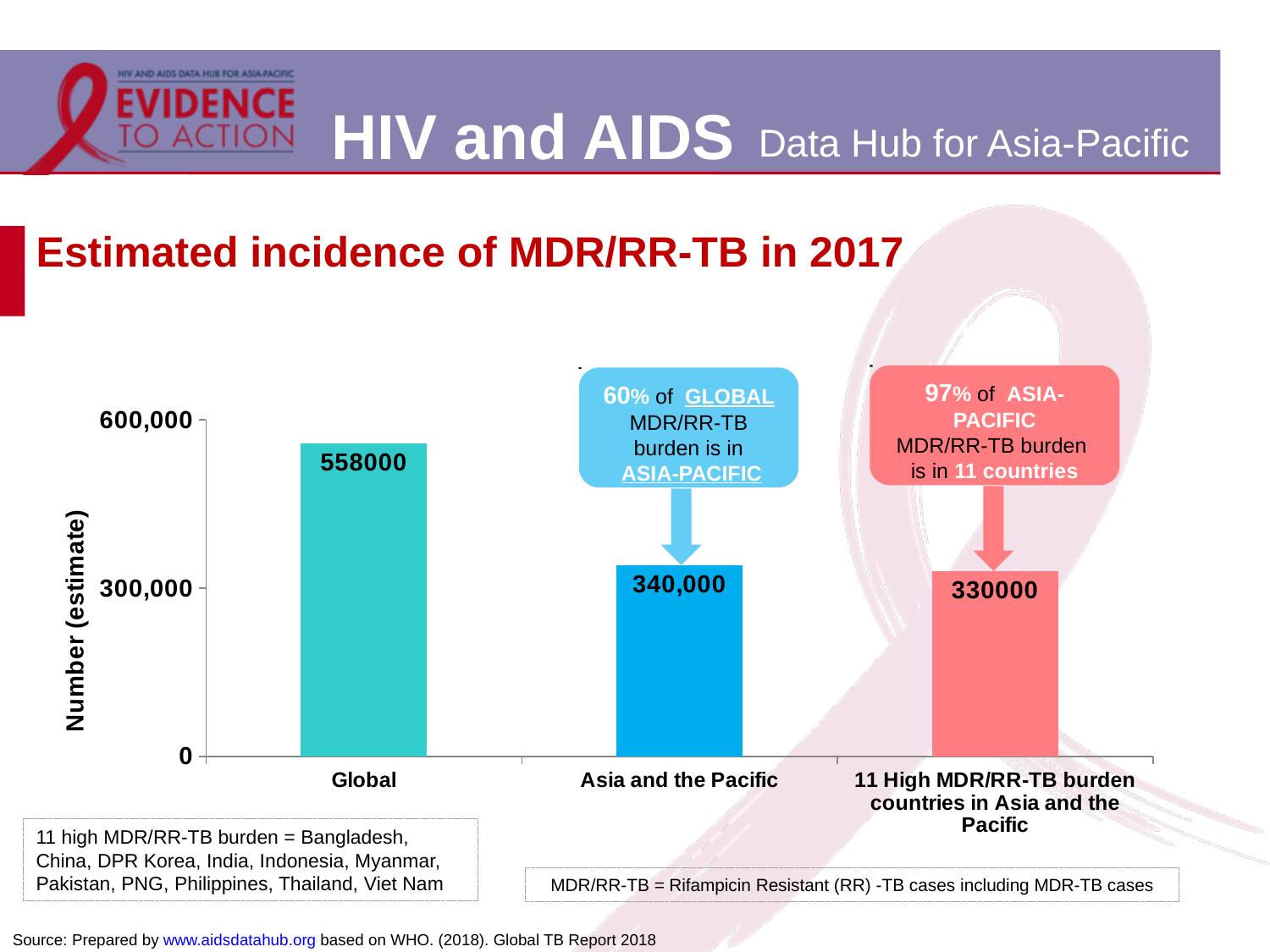
What is the difference between the Asia and the Pacific value and the value for the 11 High MDR/RR-TB burden countries? 10,000 What is the estimated incidence of MDR/RR-TB for Global in the chart? 558000 How many categories are shown on the x axis of the chart? 3 What is the label of the y axis of the chart? Number (estimate) Is the value for Global greater or less than 300,000? greater Which category has the lowest value in the chart? 11 High MDR/RR-TB burden countries in Asia and the Pacific Which is larger: the value for Asia and the Pacific or the value for the 11 High MDR/RR-TB burden countries in Asia and the Pacific? Asia and the Pacific What is the difference between the Global value and the Asia and the Pacific value? 218,000 What kind of chart is shown on the slide? bar chart What is the value shown for the 11 High MDR/RR-TB burden countries in Asia and the Pacific? 330000 What is the value shown for Asia and the Pacific? 340,000 Which category has the highest value in the chart? Global